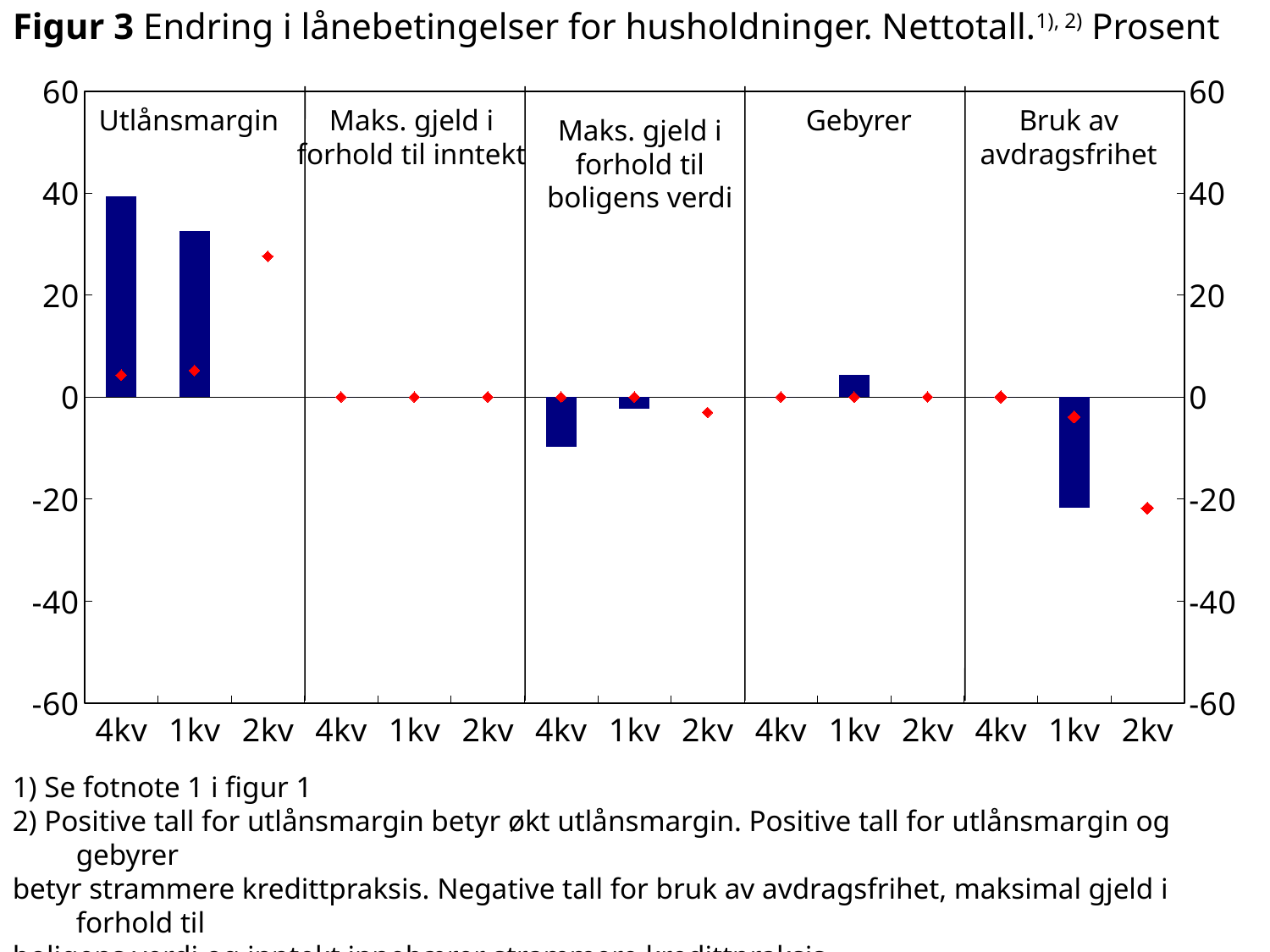
Which panel contains the tallest bar? Utlånsmargin Is the 2kv red diamond for Utlånsmargin greater or less than 20? greater What is the maximum value shown on the y axis? 60 Is the 4kv bar for Maks. gjeld i forhold til boligens verdi greater or less than 0? less In the Utlånsmargin panel, which bar is larger, 4kv or 1kv? 4kv How many loan-condition panels (categories) are shown along the x axis? 5 How many quarters are shown within each panel? 3 In the Utlånsmargin panel, do the bars rise or fall from 4kv to 1kv? fall Which panel contains the lowest (most negative) bar? Bruk av avdragsfrihet What kind of chart is shown in Figur 3? combination bar and line chart (bars with red diamond markers) Is the 4kv bar for Utlånsmargin greater or less than 20? greater